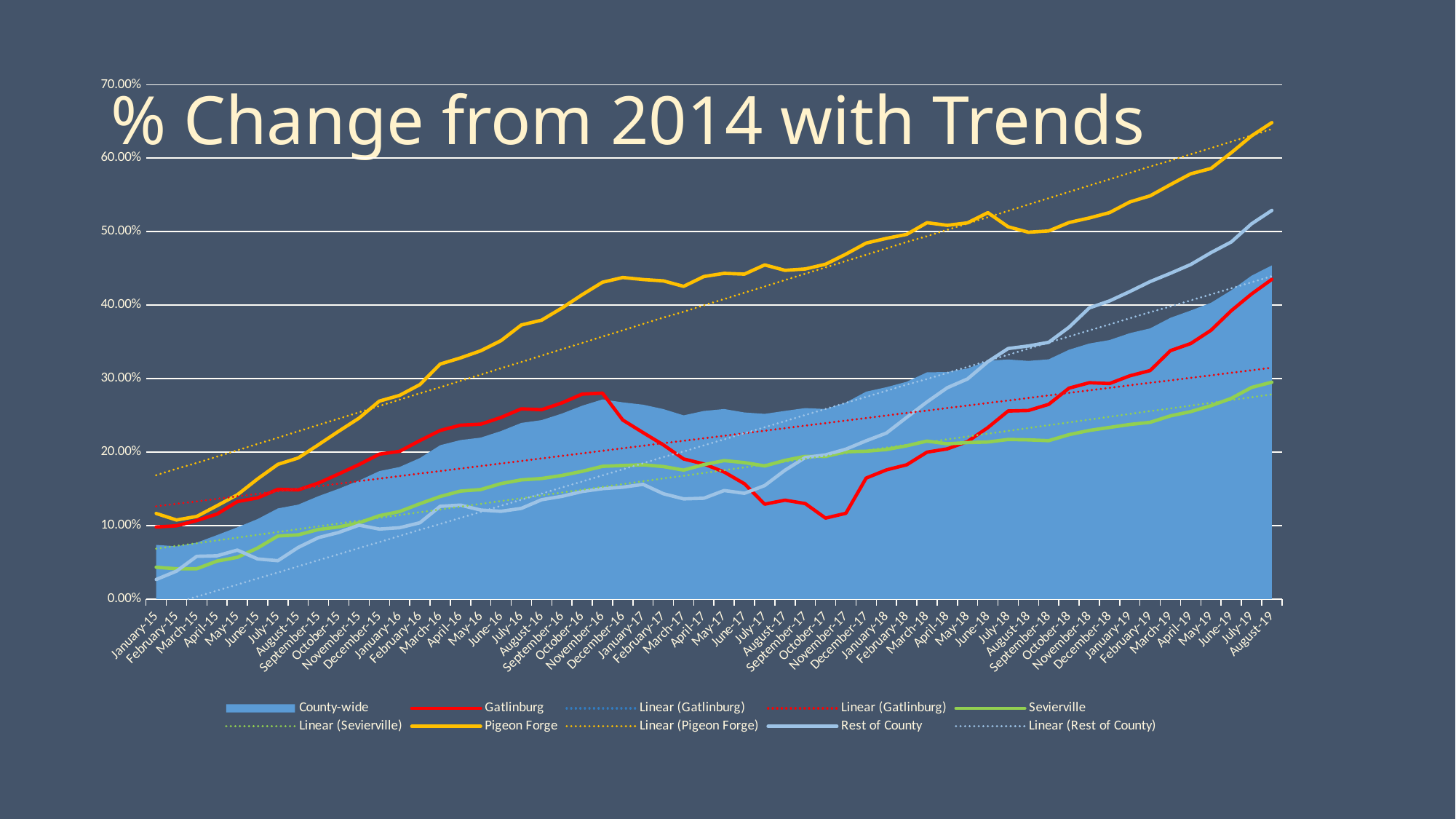
Is the value for Gatlinburg in November-16 greater or less than 20.00%? greater What is the highest value shown on the vertical axis? 70.00% Which is larger in June-16, the value for Pigeon Forge or the value for Gatlinburg? Pigeon Forge Is the value for Pigeon Forge in August-19 greater or less than 60.00%? greater Is the value for Pigeon Forge in January-15 greater or less than 20.00%? less What is the title of the chart? % Change from 2014 with Trends Which series has the highest value in August-19? Pigeon Forge How many entries does the chart's legend list? 10 Does the Pigeon Forge series generally rise or fall from January-15 to August-19? rise Which series has the lowest value in August-19? Sevierville